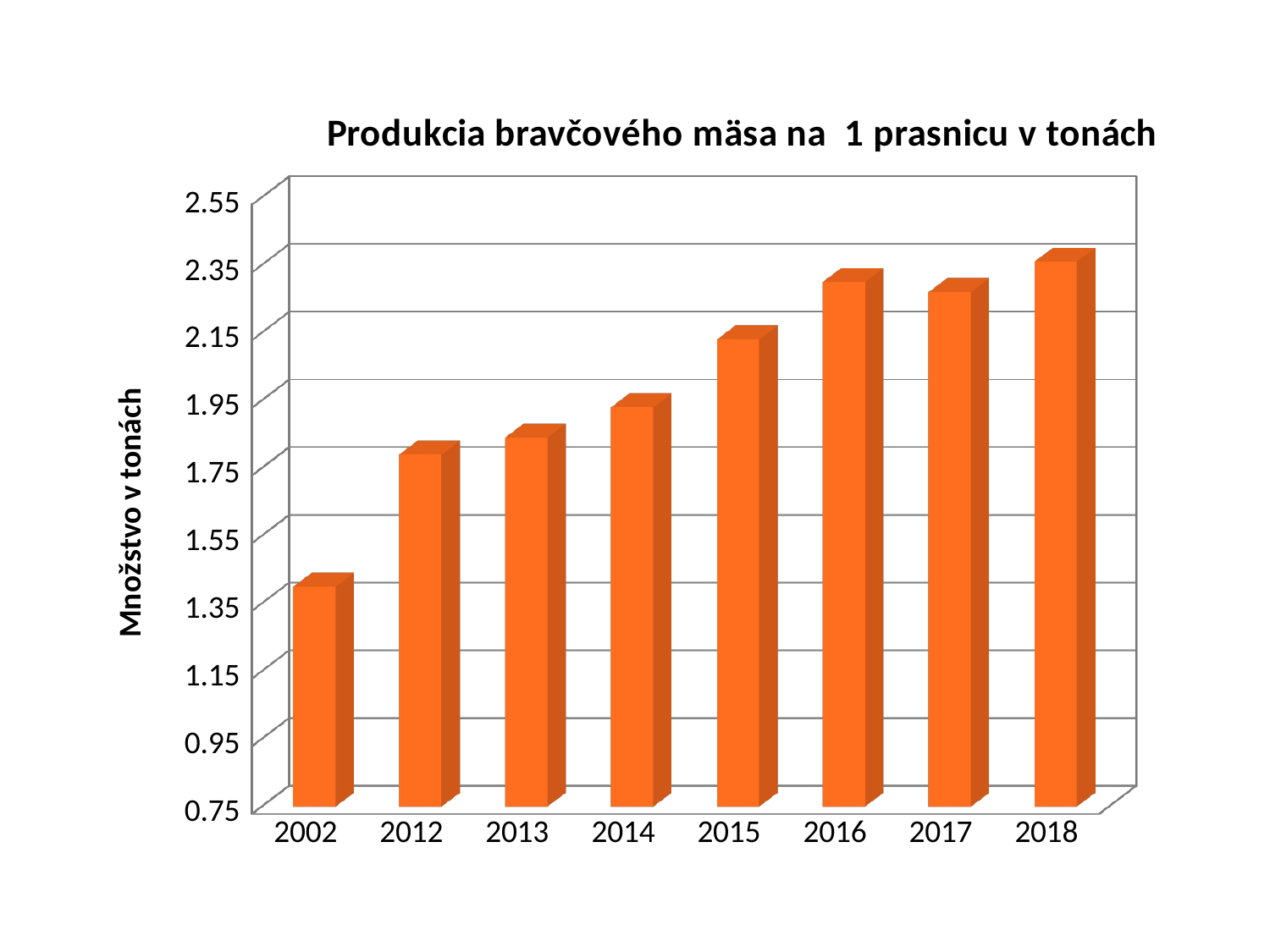
Is the value for 2002 greater or less than 1.55? less Is the value for 2016 greater or less than 2.15? greater Is the value for 2015 greater or less than 1.95? greater What is the title of the chart? Produkcia bravčového mäsa na 1 prasnicu v tonách Which year has the larger value, 2016 or 2017? 2016 How many years are shown on the x axis of the chart? 8 What kind of chart is shown on the slide? bar chart Which year has the lowest production of pork per sow? 2002 Do the values generally rise or fall from 2002 to 2018? rise Which year has the highest production of pork per sow? 2018